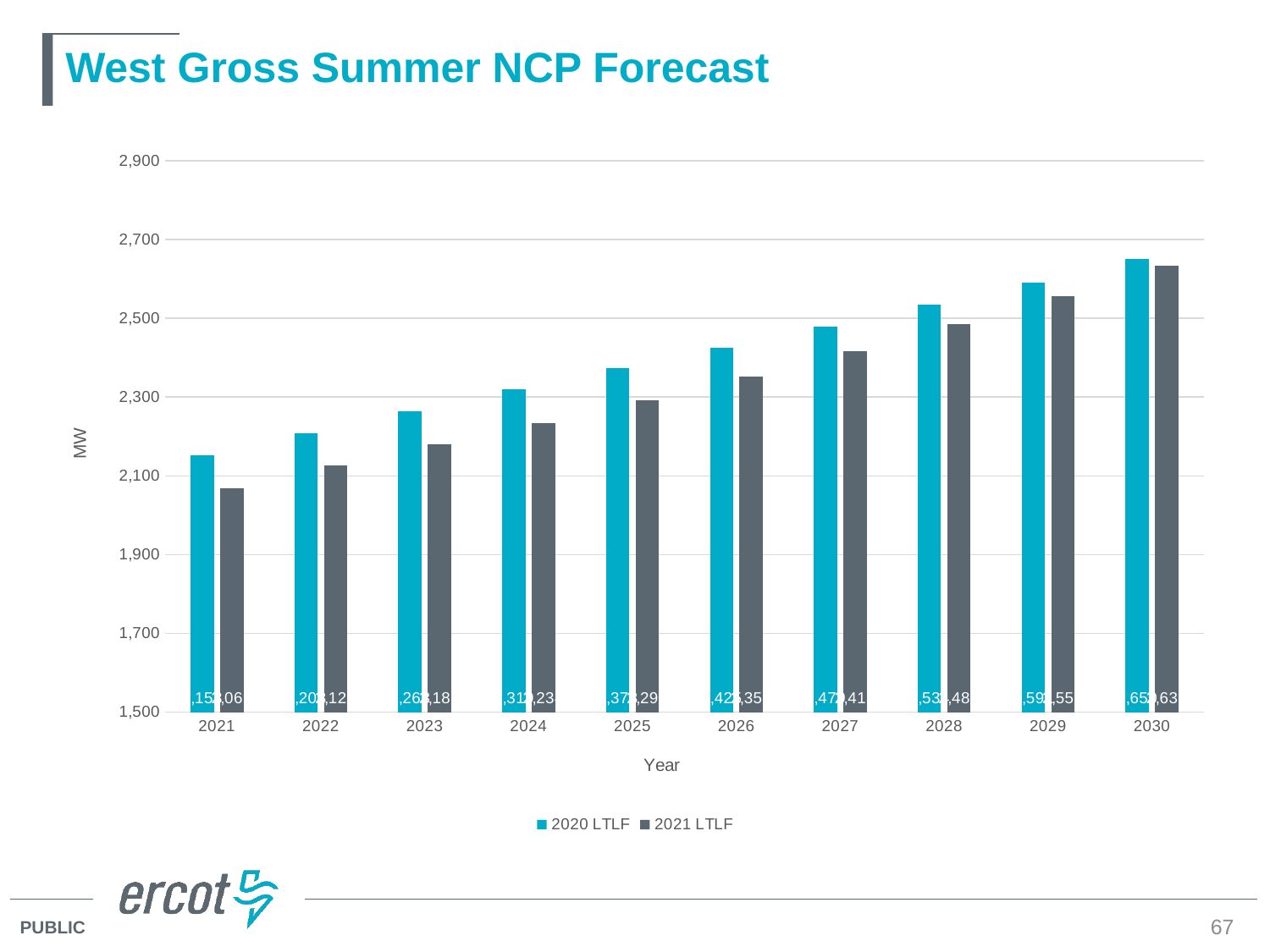
What is the title of the chart? West Gross Summer NCP Forecast Which series has the higher value in 2021, 2020 LTLF or 2021 LTLF? 2020 LTLF Is the 2020 LTLF value for 2030 greater or less than 2,700? less Is the 2020 LTLF value for 2021 greater or less than 2,100? greater Is the 2021 LTLF value for 2021 greater or less than 2,100? less How many years are shown on the x axis? 10 Which year has the highest 2020 LTLF value? 2030 What kind of chart is shown on the slide? bar chart Which year has the lowest 2021 LTLF value? 2021 How many series does the legend list? 2 Do the 2021 LTLF values rise or fall from 2021 to 2030? rise